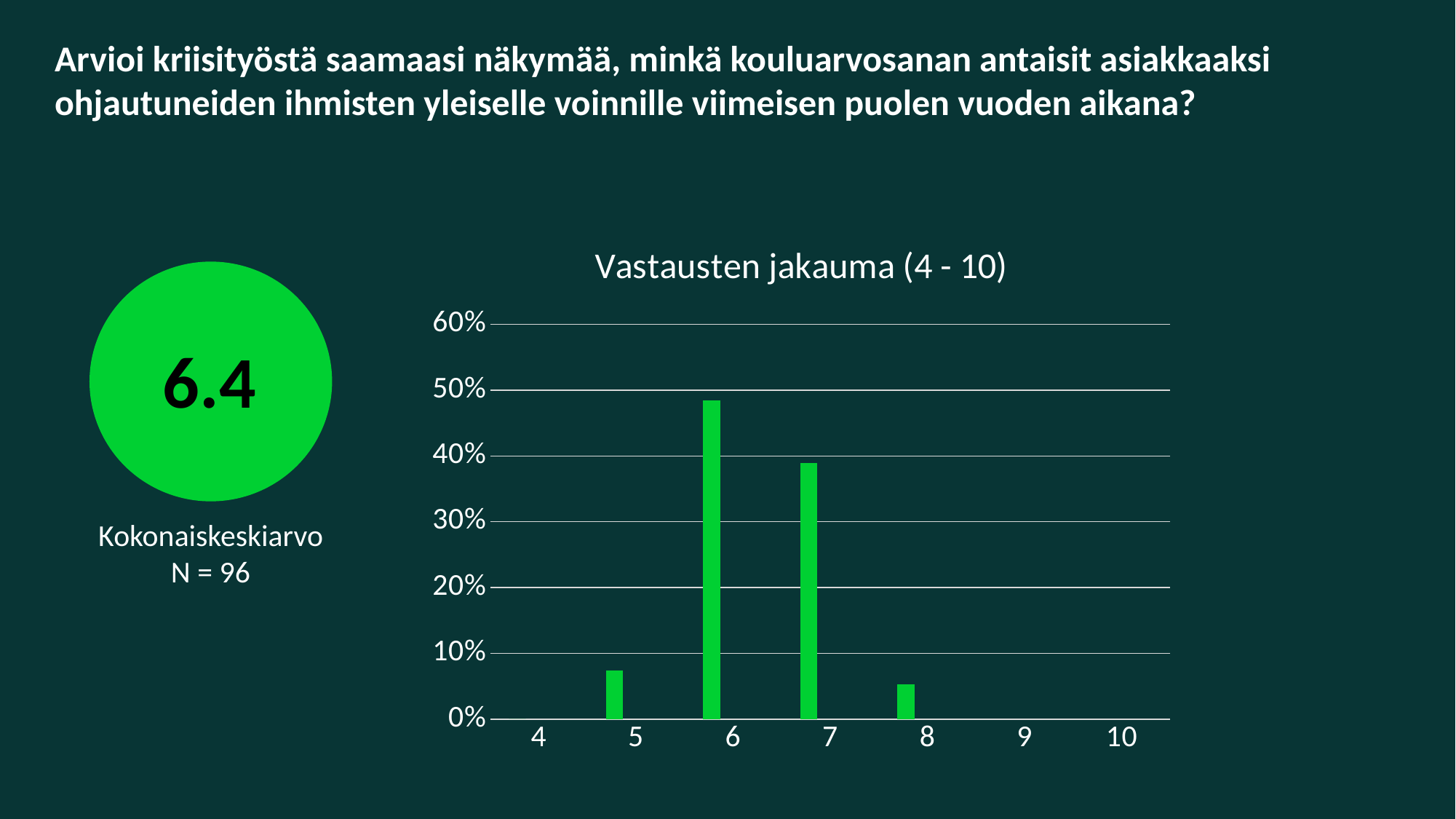
What is the overall average (Kokonaiskeskiarvo) shown next to the chart? 6.4 How many grade categories are shown on the x axis of the chart? 7 Is the value for grade 6 greater or less than 40%? greater Is the value for grade 5 greater or less than 10%? less Is the value for grade 7 greater or less than 30%? greater What is the title of the chart? Vastausten jakauma (4 - 10) What kind of chart is shown on the slide? bar chart Which grade has the highest share of responses in the chart? 6 Which has a larger share of responses, grade 6 or grade 7? 6 How many grades in the chart have a visible bar (a non-zero share)? 4